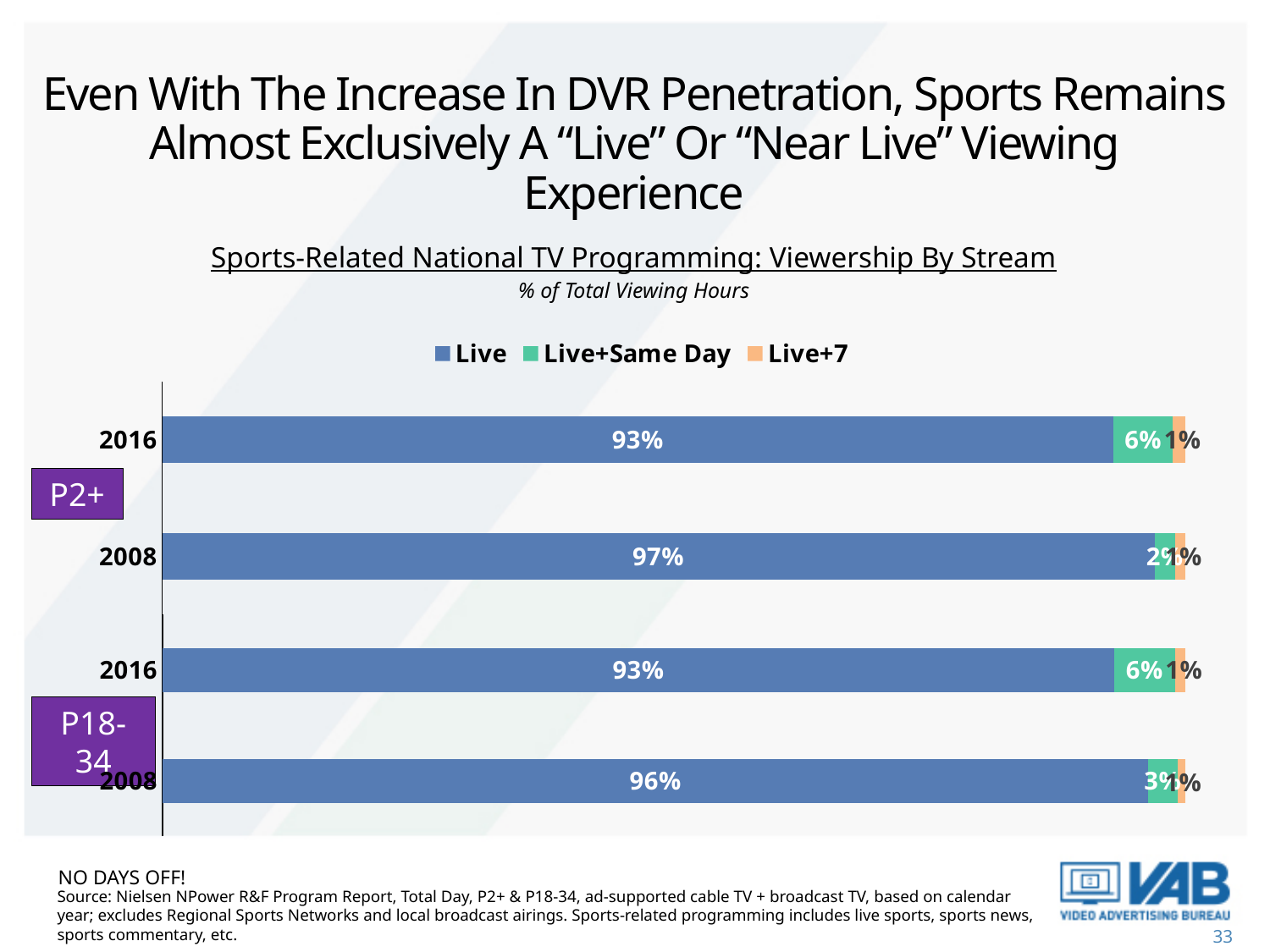
What is the Live share of total viewing hours for P2+ in 2016? 93% How many series does the legend list? 3 Is the Live share for P2+ in 2008 larger or smaller than the Live share for P18-34 in 2008? larger What is the Live+Same Day share for P18-34 in 2016? 6% What is the Live share of total viewing hours for P2+ in 2008? 97% Which bar has the highest Live share? P2+ 2008 How many bars are plotted in the chart? 4 What kind of chart is shown on the slide? stacked bar chart By how many percentage points did the Live share for P2+ fall from 2008 to 2016? 4% By how many percentage points did the Live share for P18-34 fall from 2008 to 2016? 3% What is the title of the chart? Sports-Related National TV Programming: Viewership By Stream What is the Live share of total viewing hours for P18-34 in 2008? 96%